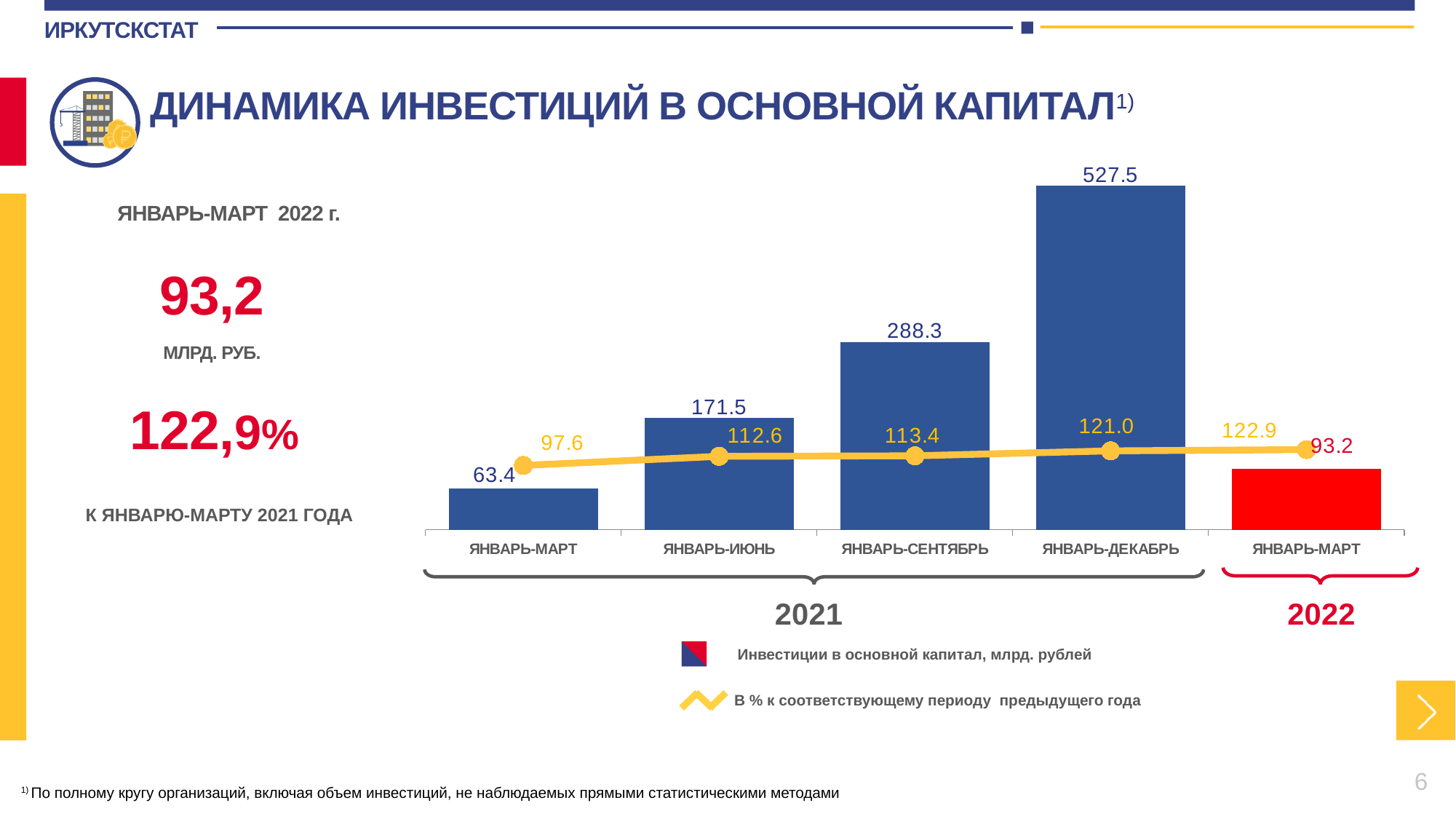
What colour is the bar for Январь-март 2022? red What is the value of the line series (В % к соответствующему периоду предыдущего года) for Январь-июнь 2021? 112.6 How many periods (categories) are shown on the x axis of the chart? 5 Which period has the lowest value of investments in fixed capital? Январь-март 2021 What is the value of the line series (В % к соответствующему периоду предыдущего года) for Январь-март 2022? 122.9 Does the line series (В % к соответствующему периоду предыдущего года) rise or fall from Январь-март 2021 to Январь-март 2022? rise How many series does the chart legend list? 2 What is the value of investments in fixed capital (млрд. рублей) for Январь-декабрь 2021? 527.5 Which period has the highest value of investments in fixed capital? Январь-декабрь 2021 Which is larger: investments in fixed capital for Январь-сентябрь 2021 or for Январь-июнь 2021? Январь-сентябрь 2021 What is the difference in investments in fixed capital between Январь-март 2022 and Январь-март 2021? 29.8 What is the value of investments in fixed capital (млрд. рублей) for Январь-март 2022? 93.2